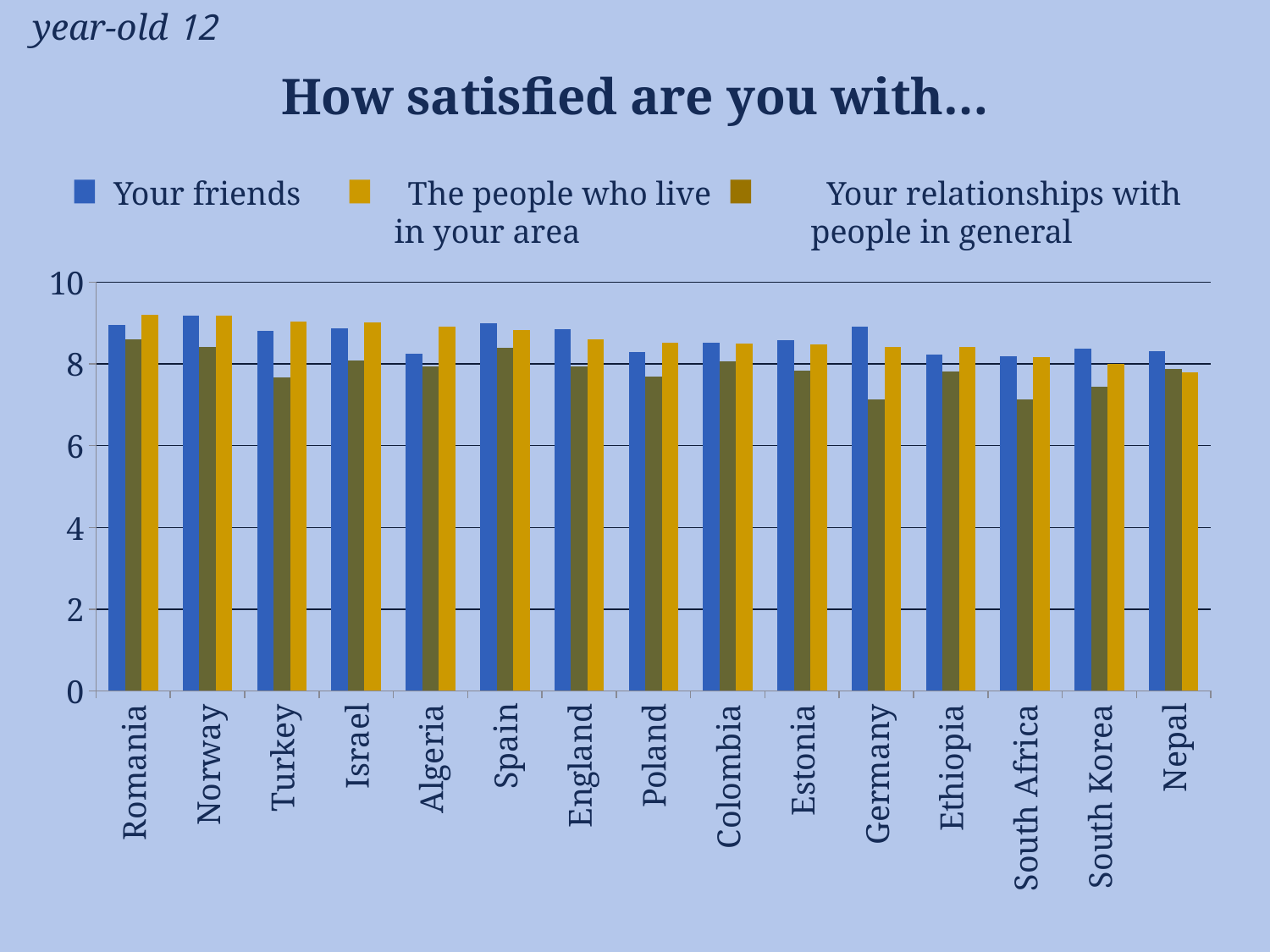
How many countries are shown on the x axis of the chart? 15 Is the value for Turkey in the 'Your relationships with people in general' series greater or less than 8? less Is the value for South Korea in the 'Your relationships with people in general' series greater or less than 8? less Is the value for Germany in the 'Your relationships with people in general' series greater or less than 8? less What kind of chart is shown on the slide? bar chart What is the title of the chart? How satisfied are you with... Which colour represents the 'Your friends' series in the chart? blue How many series does the chart's legend list? 3 For Germany, which is larger: the 'Your friends' value or the 'Your relationships with people in general' value? Your friends For Algeria, which is larger: the 'Your friends' value or the 'The people who live in your area' value? The people who live in your area